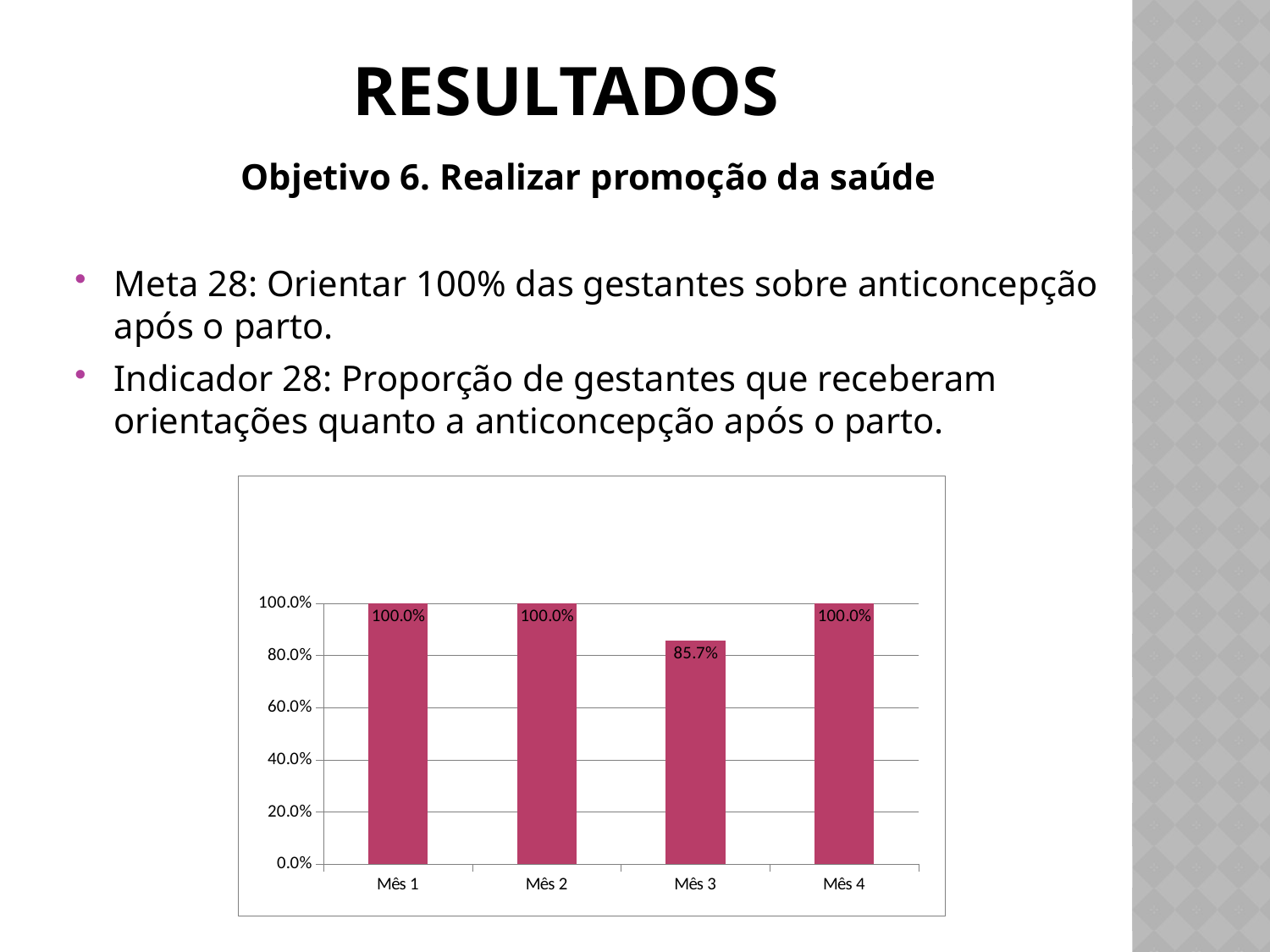
Is the value for Mês 3 greater or less than 80.0%? greater What is the value for Mês 3? 85.7% Which month has the lowest value? Mês 3 Which is larger, the value for Mês 3 or the value for Mês 4? Mês 4 What is the value for Mês 4? 100.0% What is the highest value shown on the y axis? 100.0% How many bars reach 100.0%? 3 How many months are shown on the x axis? 4 What is the value for Mês 1? 100.0% What colour are the bars in the chart? magenta/pink What kind of chart is shown on the slide? bar chart What is the difference between the values for Mês 2 and Mês 3? 14.3%